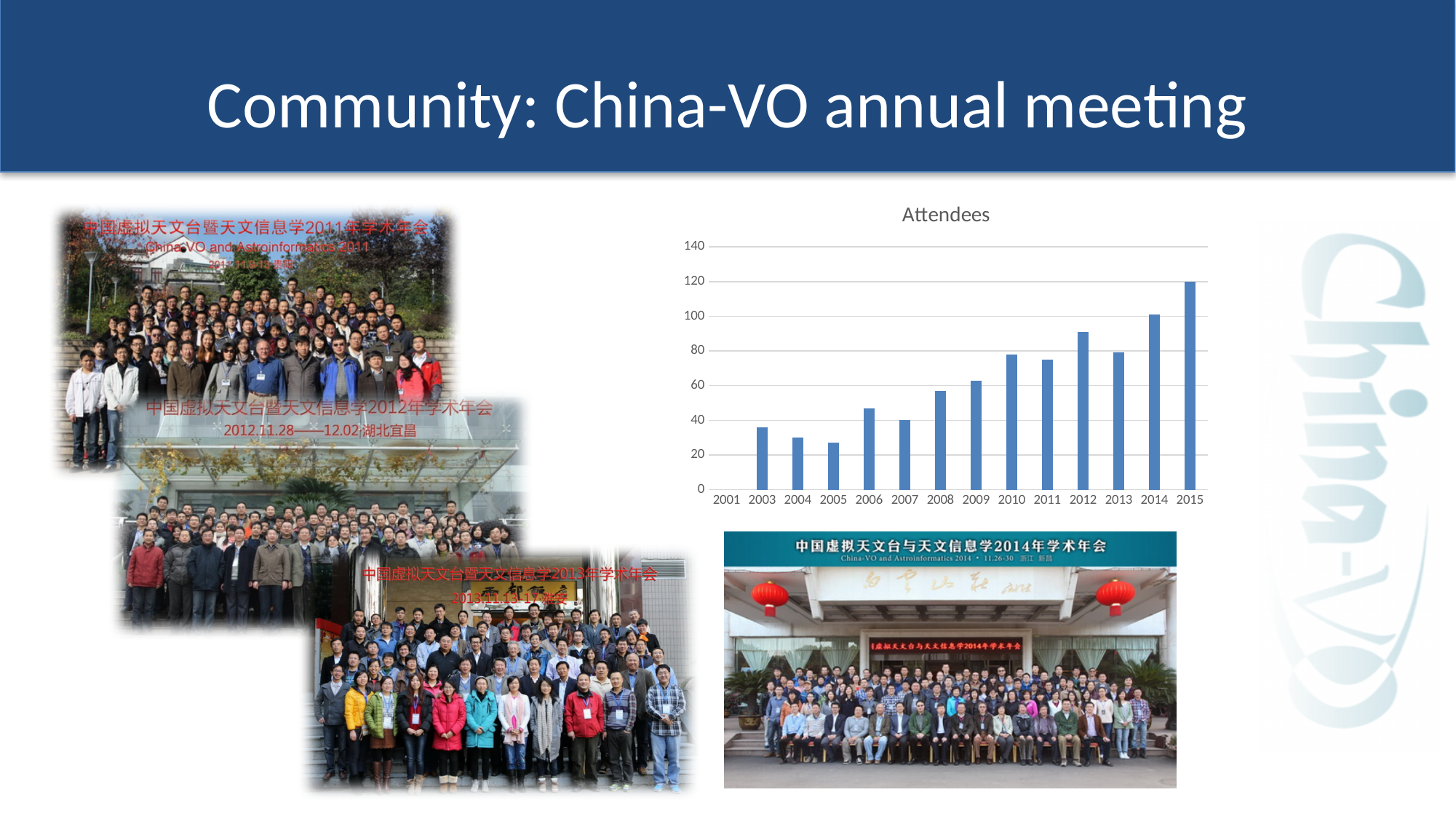
Which year has more attendees, 2014 or 2010? 2014 Which year has more attendees, 2012 or 2013? 2012 What kind of chart is shown on the slide? bar chart Which year has the lowest number of attendees? 2005 Is the value for 2003 greater or less than 40? less Which year has the highest number of attendees? 2015 What is the title of the chart? Attendees Is the value for 2006 greater or less than 40? greater Overall, do attendee numbers rise or fall from 2003 to 2015? rise Is the value for 2015 greater or less than 100? greater